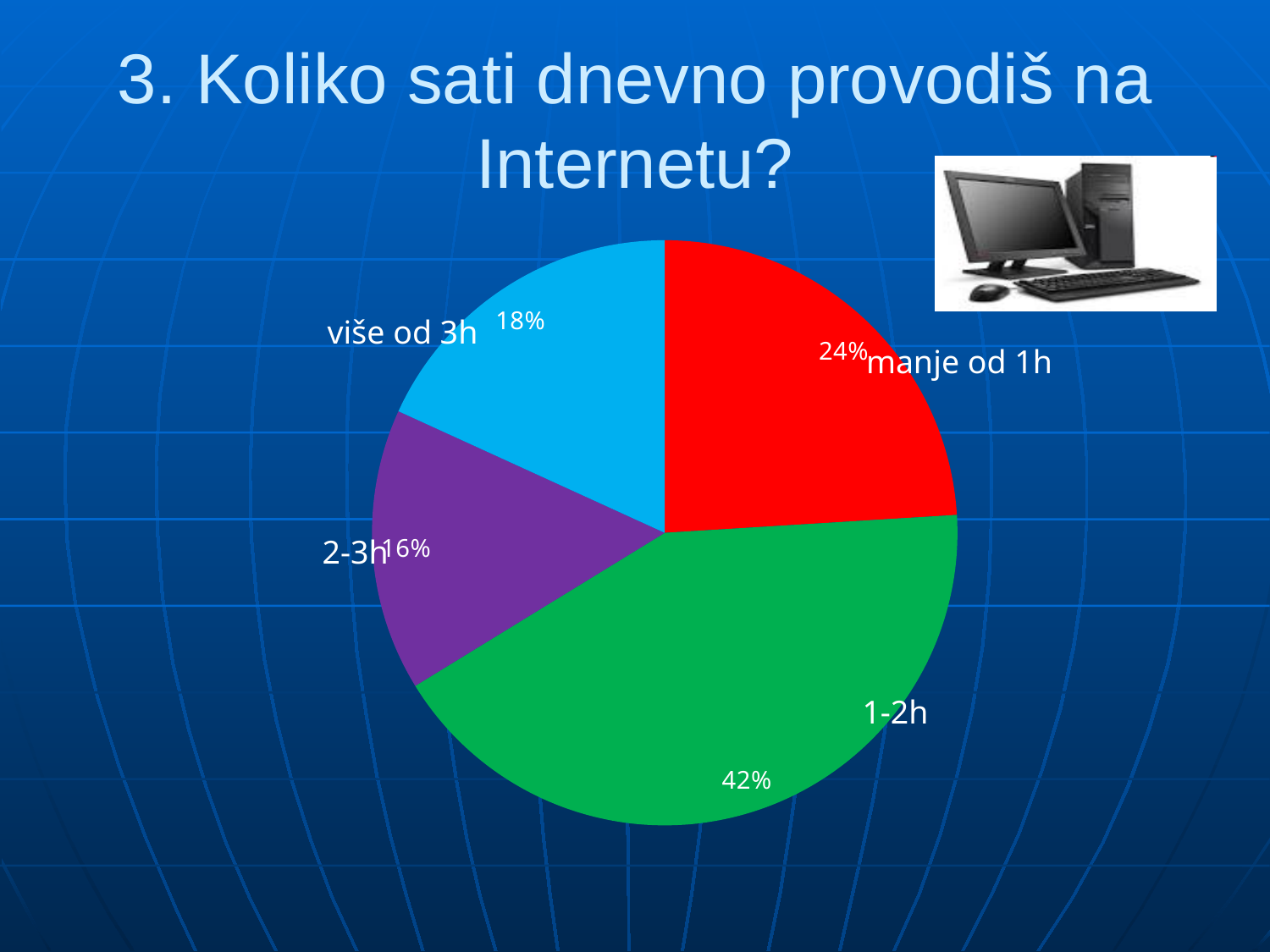
What percentage of respondents spend 1-2h on the Internet daily? 42% How many categories (slices) does the pie chart have? 4 What kind of chart is shown on the slide? pie chart What colour is the slice for '1-2h'? green What percentage is shown for '2-3h'? 16% What percentage is shown for 'više od 3h'? 18% Which is larger, the share for 'manje od 1h' or the share for 'više od 3h'? manje od 1h Which category has the largest share of the pie? 1-2h What colour is the slice for 'manje od 1h'? red What percentage is shown for 'manje od 1h'? 24% What is the difference in percentage points between '1-2h' and 'manje od 1h'? 18 Which category has the smallest share of the pie? 2-3h